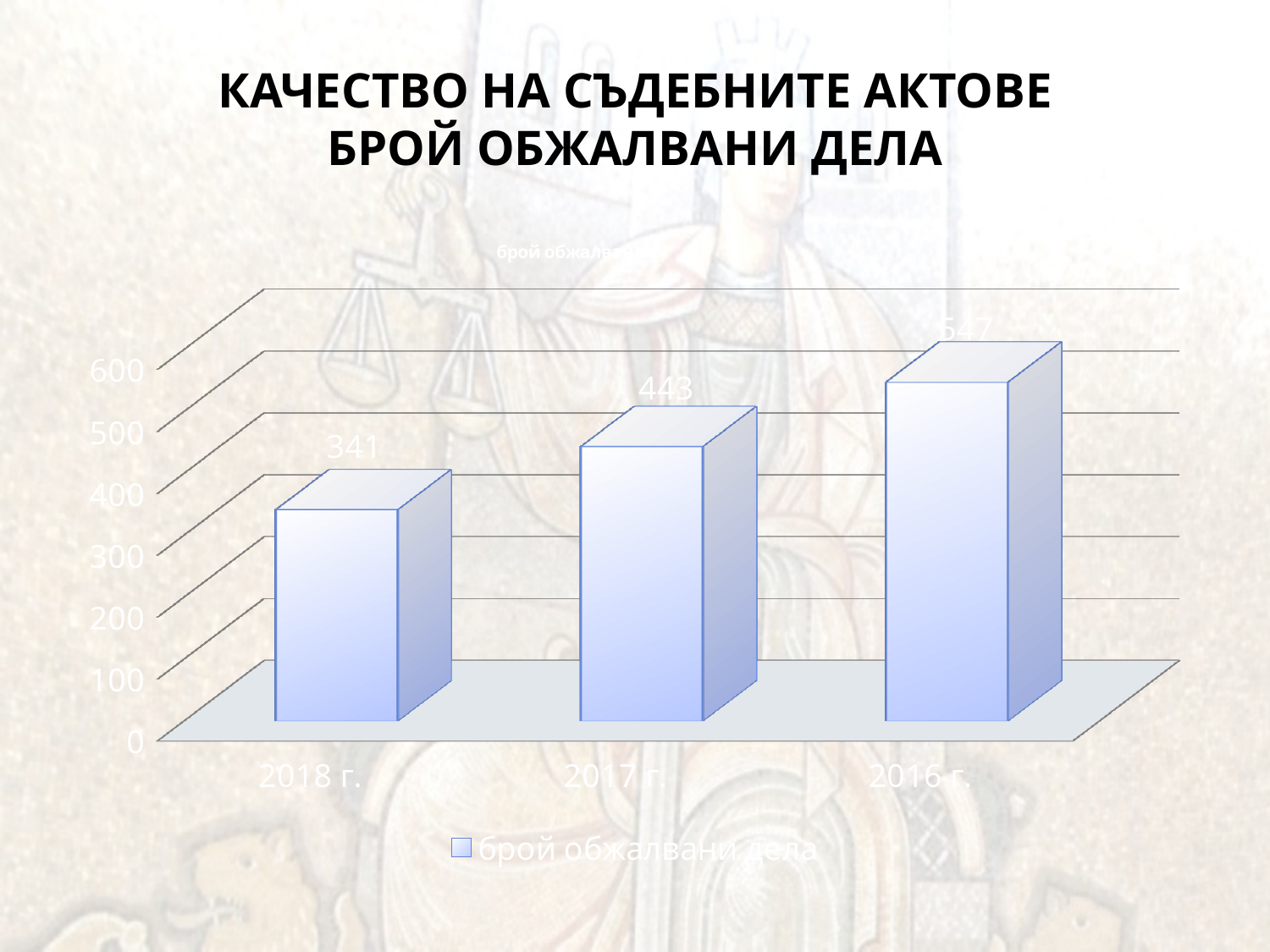
Is the value for 2017 г. greater or less than 400? greater Which category has the highest value? 2016 г. Which is larger, the value for 2017 г. or the value for 2016 г.? 2016 г. What is the value for 2017 г.? 443 What is the difference between the values for 2017 г. and 2018 г.? 102 How many categories are shown on the x axis? 3 What kind of chart is shown on the slide? bar chart What is the difference between the values for 2016 г. and 2018 г.? 206 Which category has the lowest value? 2018 г. Do the values rise or fall moving left to right along the x axis? rise What is the value for 2016 г.? 547 What is the value for 2018 г.? 341